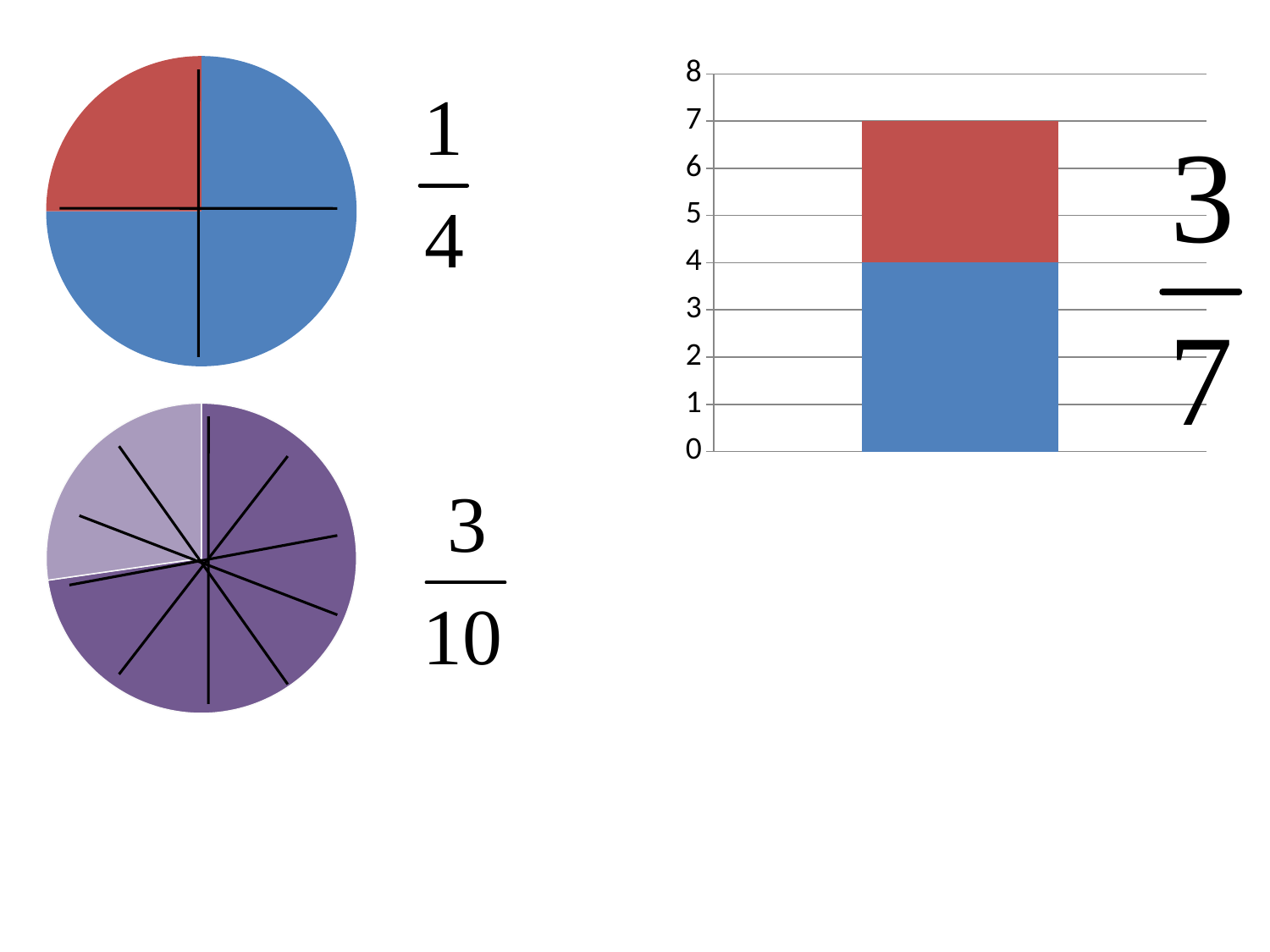
In the bar chart on the right, how tall is the red segment on its own? 3 In the top-left pie chart, what fraction of the circle is shaded red? 1/4 What kind of chart is shown on the right side of the slide? bar chart In the bar chart on the right, what is the total height of the stacked bar? 7 In the bar chart on the right, what value does the top of the blue segment reach on the axis? 4 What kind of chart is shown at the top left of the slide? pie chart In the bottom-left pie chart, how many equal sectors is the circle divided into? 10 In the bar chart on the right, which segment is larger, the blue one or the red one? blue In the bar chart on the right, how many bars are plotted? 1 What kind of chart is shown at the bottom left of the slide? pie chart In the bar chart on the right, what is the highest value shown on the vertical axis? 8 In the bar chart on the right, what value does the top of the red segment reach on the axis? 7